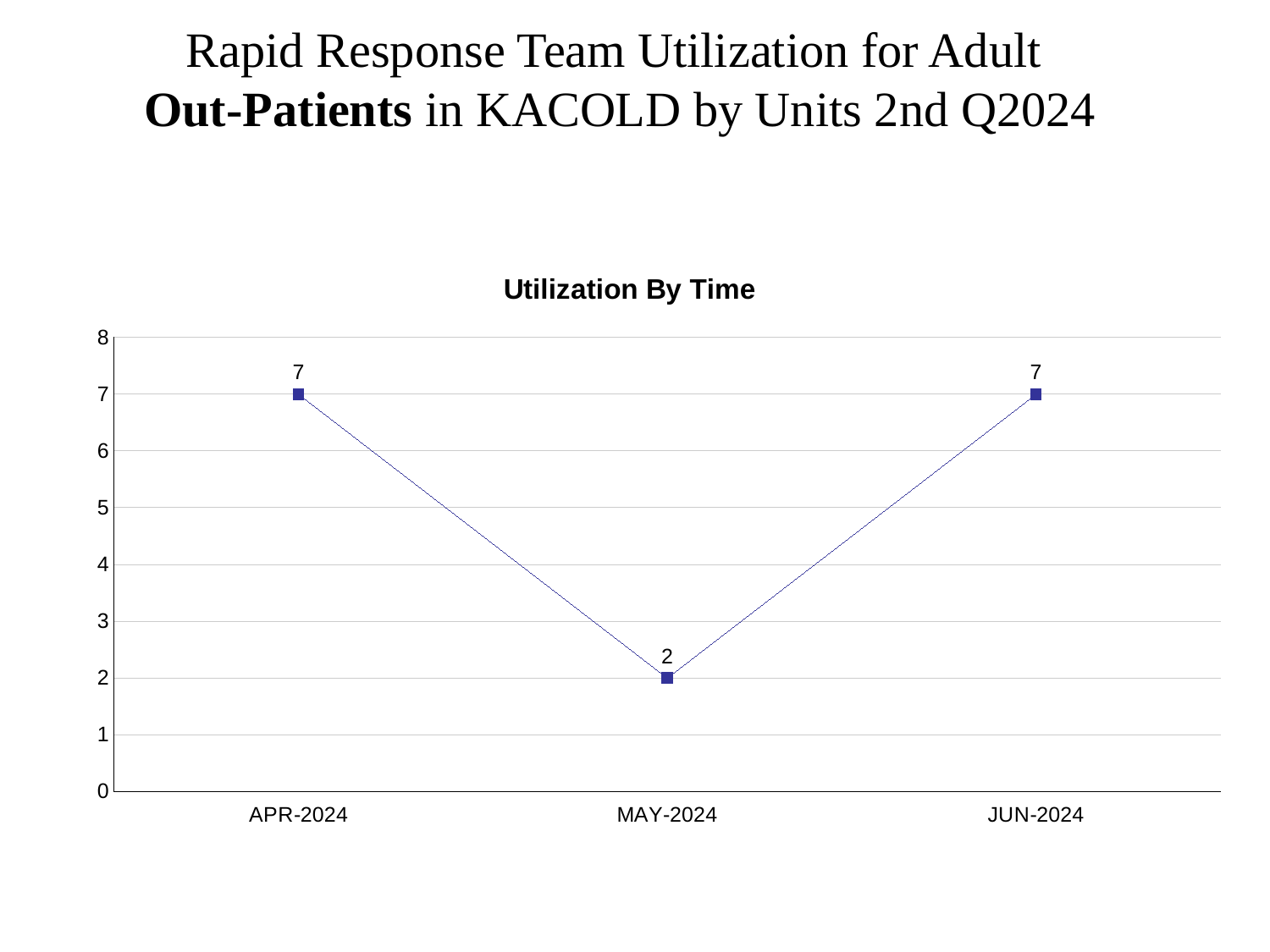
What is the title of the chart? Utilization By Time Which month has the lowest value? MAY-2024 What is the value for APR-2024? 7 What is the highest value shown on the vertical axis? 8 What is the difference between the values for APR-2024 and MAY-2024? 5 Is the value for MAY-2024 greater or less than 4? less What is the value for MAY-2024? 2 Does the value rise or fall from APR-2024 to MAY-2024? fall What kind of chart is shown on the slide? line chart What is the value for JUN-2024? 7 How many data points are plotted on the chart? 3 Which is larger, the value for MAY-2024 or the value for JUN-2024? JUN-2024